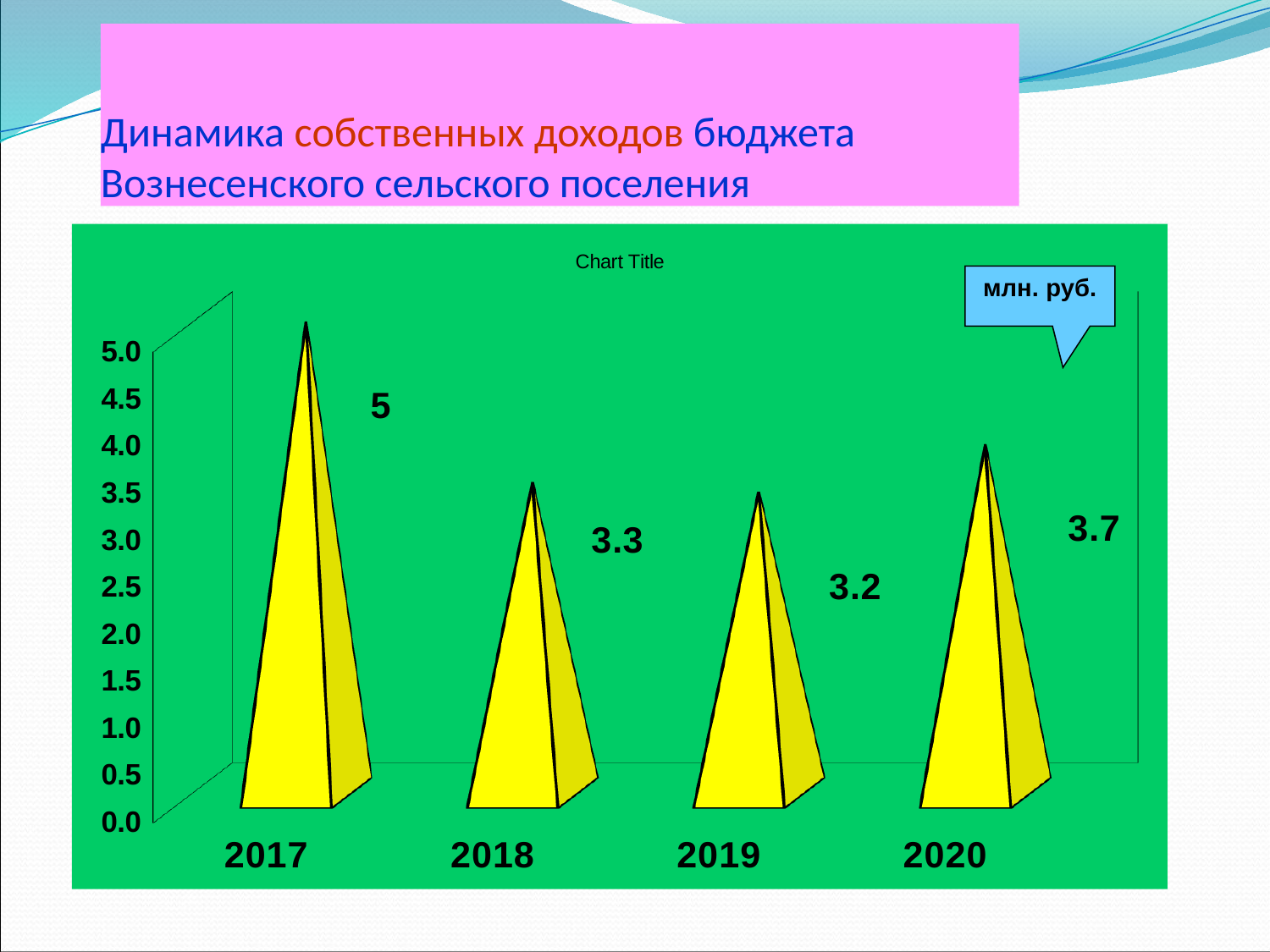
How many years are shown on the x axis? 4 Which is larger, the value for 2018 or the value for 2020? 2020 What is the value for 2020? 3.7 What unit is shown in the callout box on the chart? млн. руб. What is the value for 2017? 5 What is the difference between the values for 2017 and 2020? 1.3 Which year has the lowest value? 2019 Which year has the highest value? 2017 What is the value for 2019? 3.2 What kind of chart is this? bar chart What is the value for 2018? 3.3 Is the value for 2020 greater or less than 3.5? greater